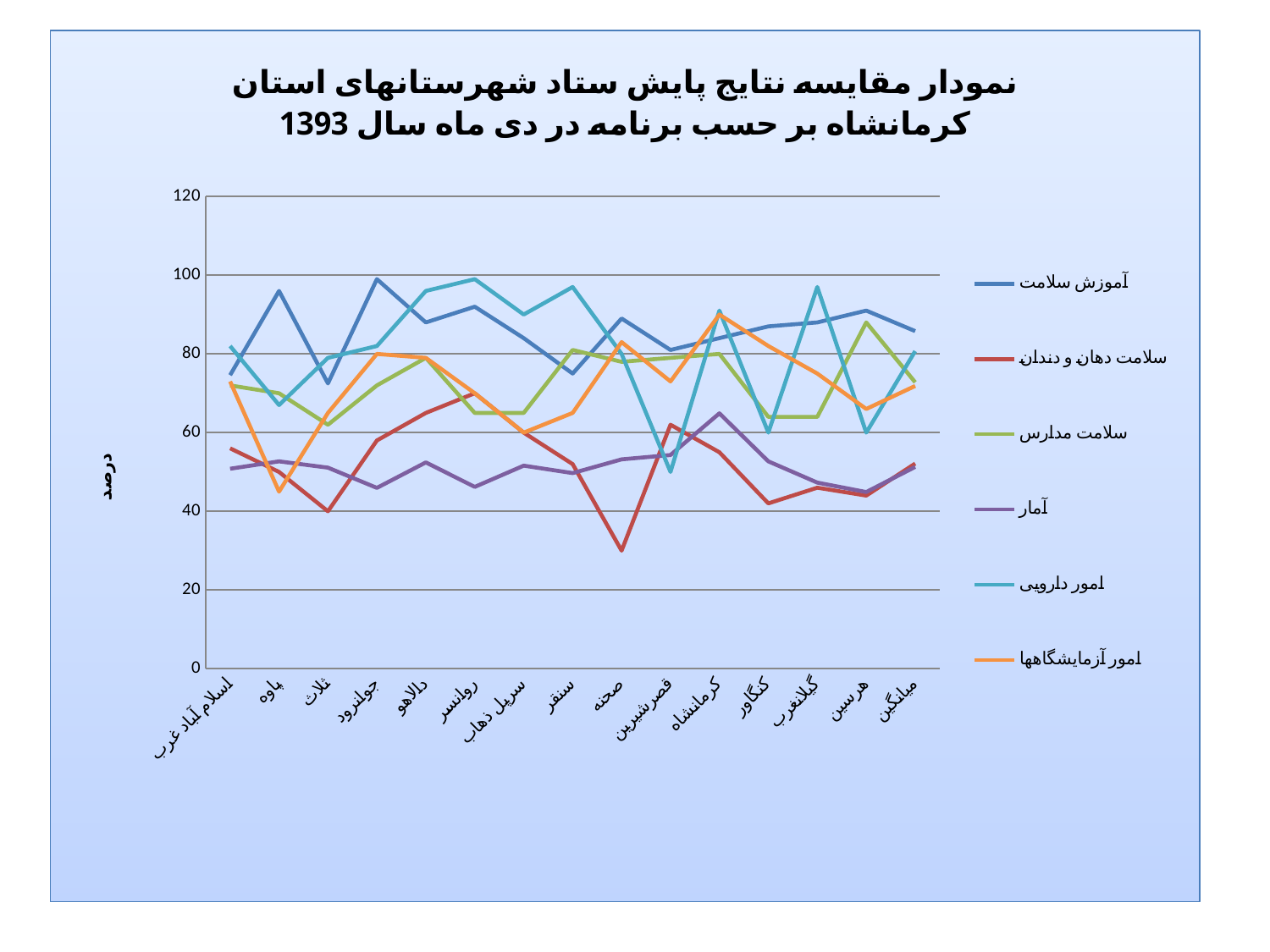
Is the value for سلامت مدارس at هرسین greater or less than 80? greater Is the value for آموزش سلامت at جوانرود greater or less than 80? greater How many categories are shown along the x axis? 15 Is the value for امور آزمایشگاهها at پاوه greater or less than 60? less For the series سلامت دهان و دندان, which category has the lowest value? صحنه What is the title of the vertical axis? درصد At صحنه, which series has the larger value: آموزش سلامت or سلامت دهان و دندان? آموزش سلامت What kind of chart is shown on the slide? line chart How many series does the legend list? 6